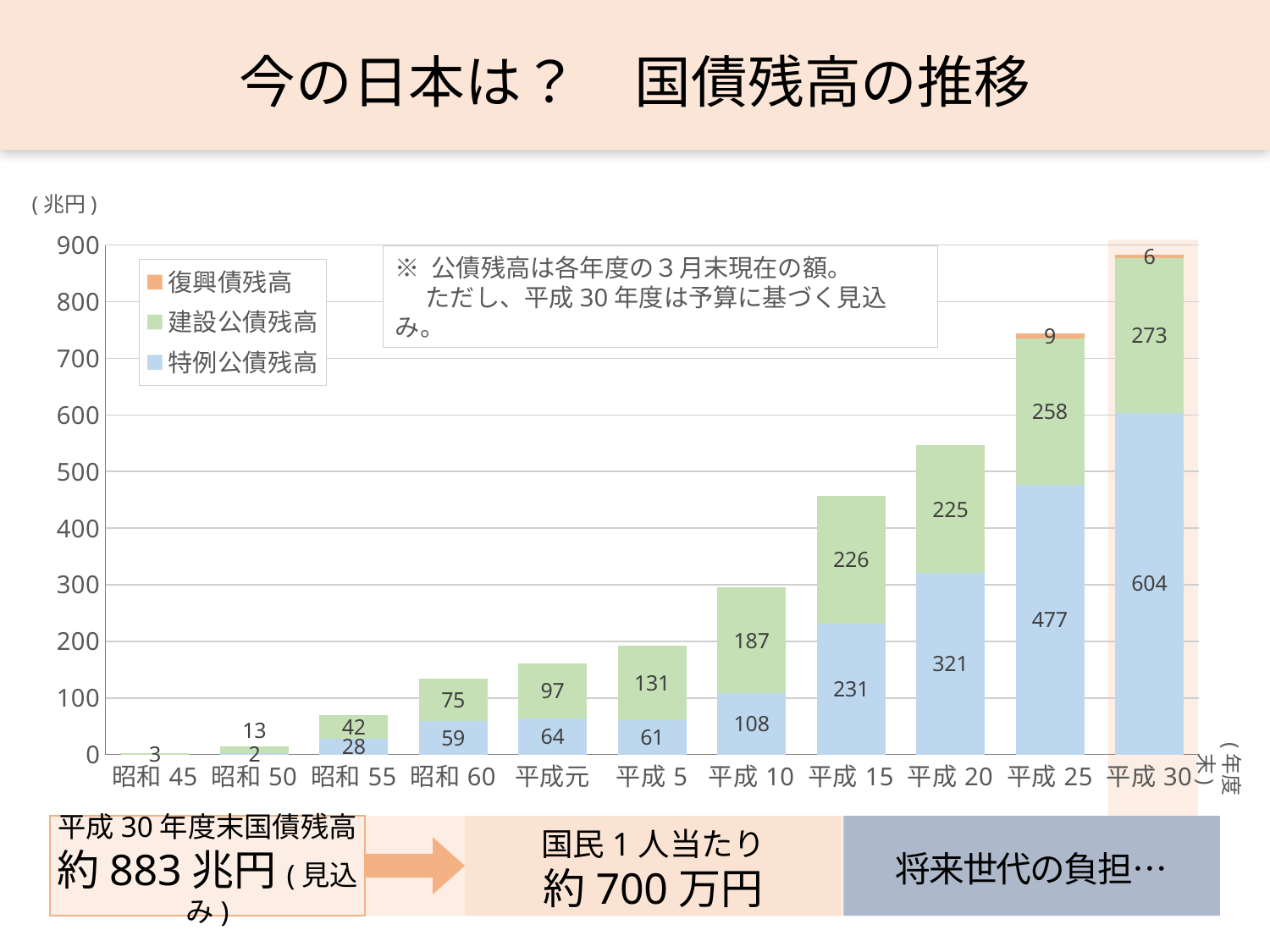
What is the difference between 特例公債残高 for 平成 30 and 平成 25? 127 What kind of chart is shown? stacked bar chart Is the total bar for 平成 20 greater or less than 500? greater What is the value of 特例公債残高 for 平成 30? 604 How many years are shown on the x axis? 11 Which is larger for 平成 15: 特例公債残高 or 建設公債残高? 特例公債残高 Which year has the highest 特例公債残高? 平成 30 What is the value of 復興債残高 for 平成 25? 9 How many series does the legend list? 3 Which year has the lowest total bar? 昭和 45 What is the total of the stacked bar for 平成 25? 744 What is the value of 建設公債残高 for 平成 10? 187